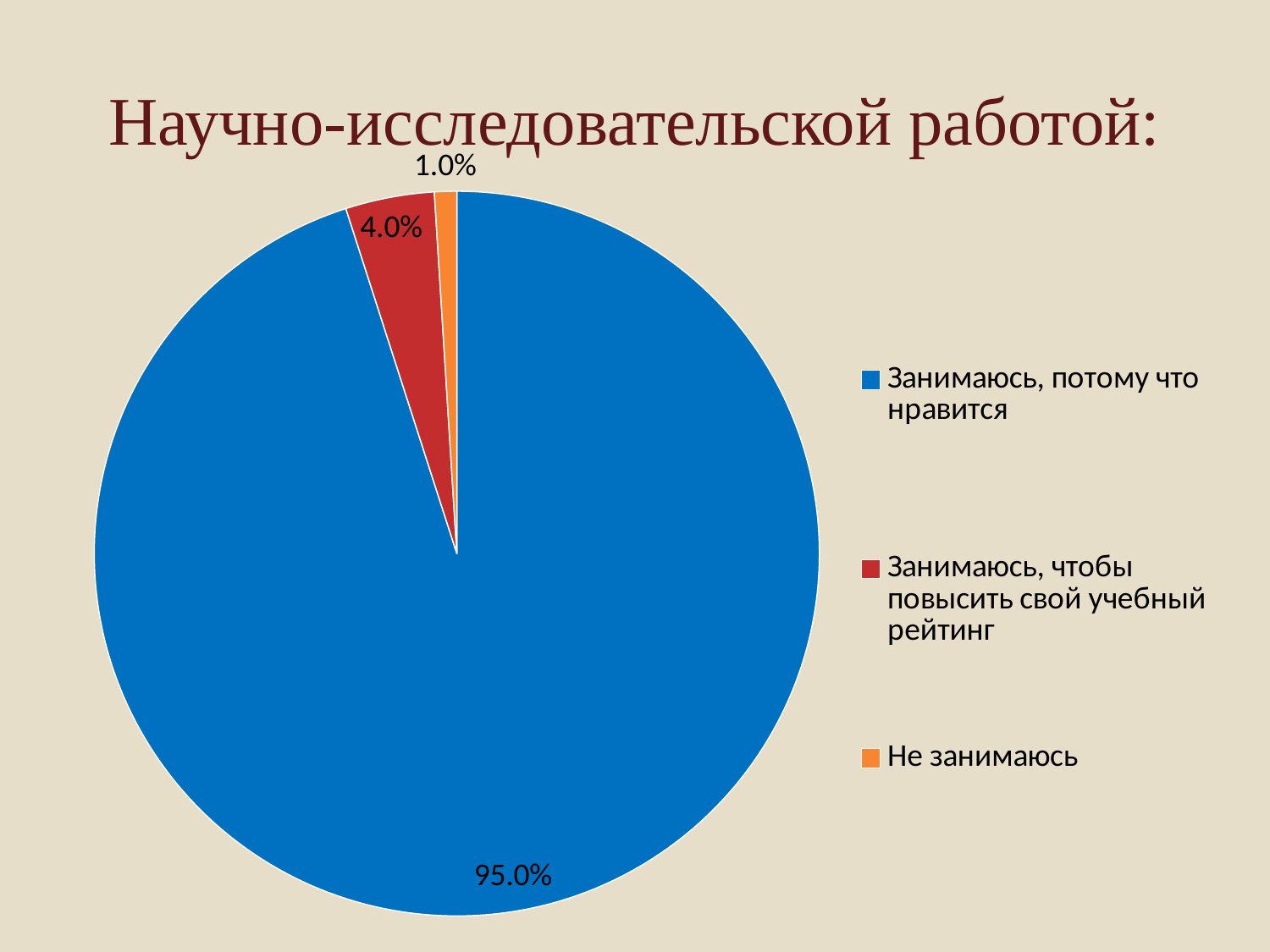
What is the title of the slide above the chart? Научно-исследовательской работой: What colour is the slice for "Не занимаюсь"? orange How many categories does the pie chart show? 3 What is the difference between the shares of "Занимаюсь, чтобы повысить свой учебный рейтинг" and "Не занимаюсь"? 3.0% What share of the pie does "Занимаюсь, потому что нравится" have? 95.0% Which category has the smallest slice of the pie? Не занимаюсь What share of the pie does "Не занимаюсь" have? 1.0% Which category has the largest slice of the pie? Занимаюсь, потому что нравится What kind of chart is shown on the slide? pie chart Which is larger: the share for "Занимаюсь, чтобы повысить свой учебный рейтинг" or the share for "Не занимаюсь"? Занимаюсь, чтобы повысить свой учебный рейтинг What share of the pie does "Занимаюсь, чтобы повысить свой учебный рейтинг" have? 4.0% What is the difference between the shares of "Занимаюсь, потому что нравится" and "Занимаюсь, чтобы повысить свой учебный рейтинг"? 91.0%